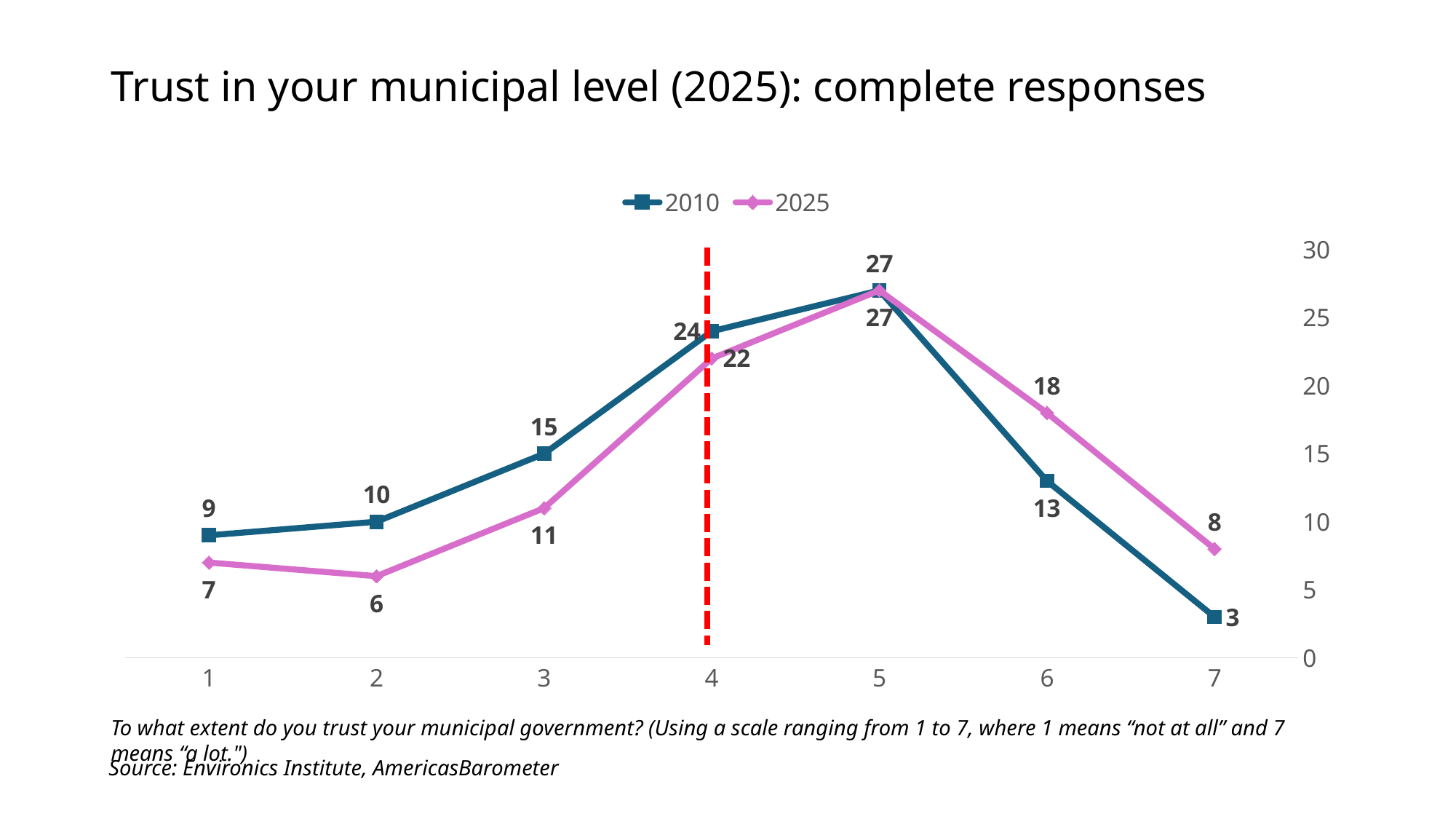
What kind of chart is shown on the slide? Line chart What is the value for the 2025 series at scale point 6? 18 What is the title of the chart? Trust in your municipal level (2025): complete responses At which scale point is the 2010 series lowest? 7 Which series has the larger value at scale point 7, 2010 or 2025? 2025 At which scale point does the 2010 series reach its highest value? 5 What is the value for the 2025 series at scale point 2? 6 What is the value for the 2010 series at scale point 4? 24 How many scale points are plotted on the x axis? 7 Is the value for 2025 at scale point 4 greater or less than 20? greater What is the difference between the 2010 and 2025 values at scale point 3? 4 How many series does the legend list? 2